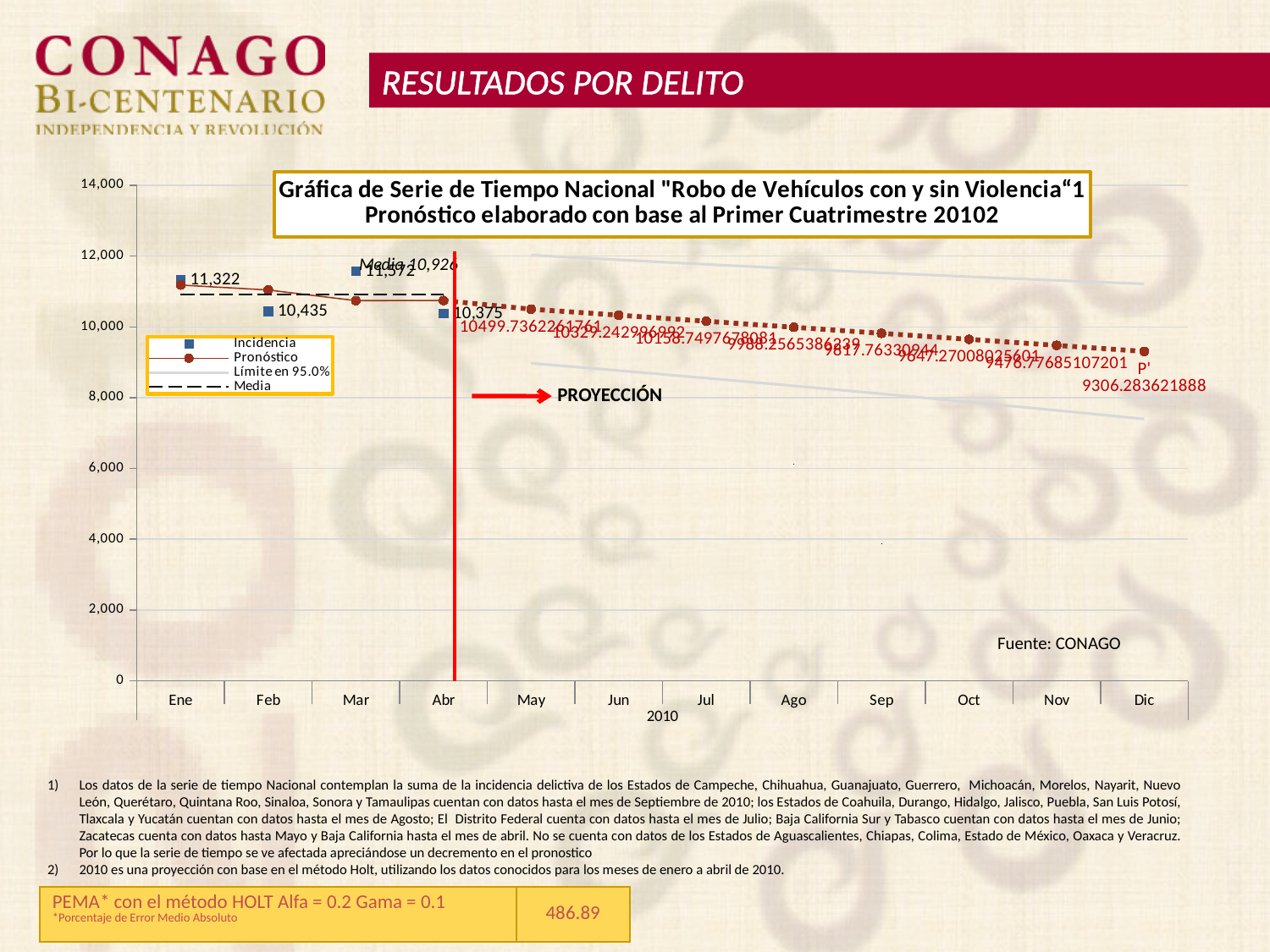
How many months are shown on the x axis? 12 What is the value of the Media line? 10,926 What is the difference between the Incidencia values for Ene and Feb? 887 What is the Incidencia value for Feb? 10,435 How many series does the legend list? 4 What is the Incidencia value for Abr? 10,375 Is the Pronóstico value for Dic greater or less than 10,000? less Which is larger, the Incidencia value for Ene or for Feb? Ene Does the Pronóstico series rise or fall from May to Dic? fall What is the Incidencia value for Ene? 11,322 What kind of chart is shown on the slide? line chart What is the Pronóstico value for Dic? 9306.283621888